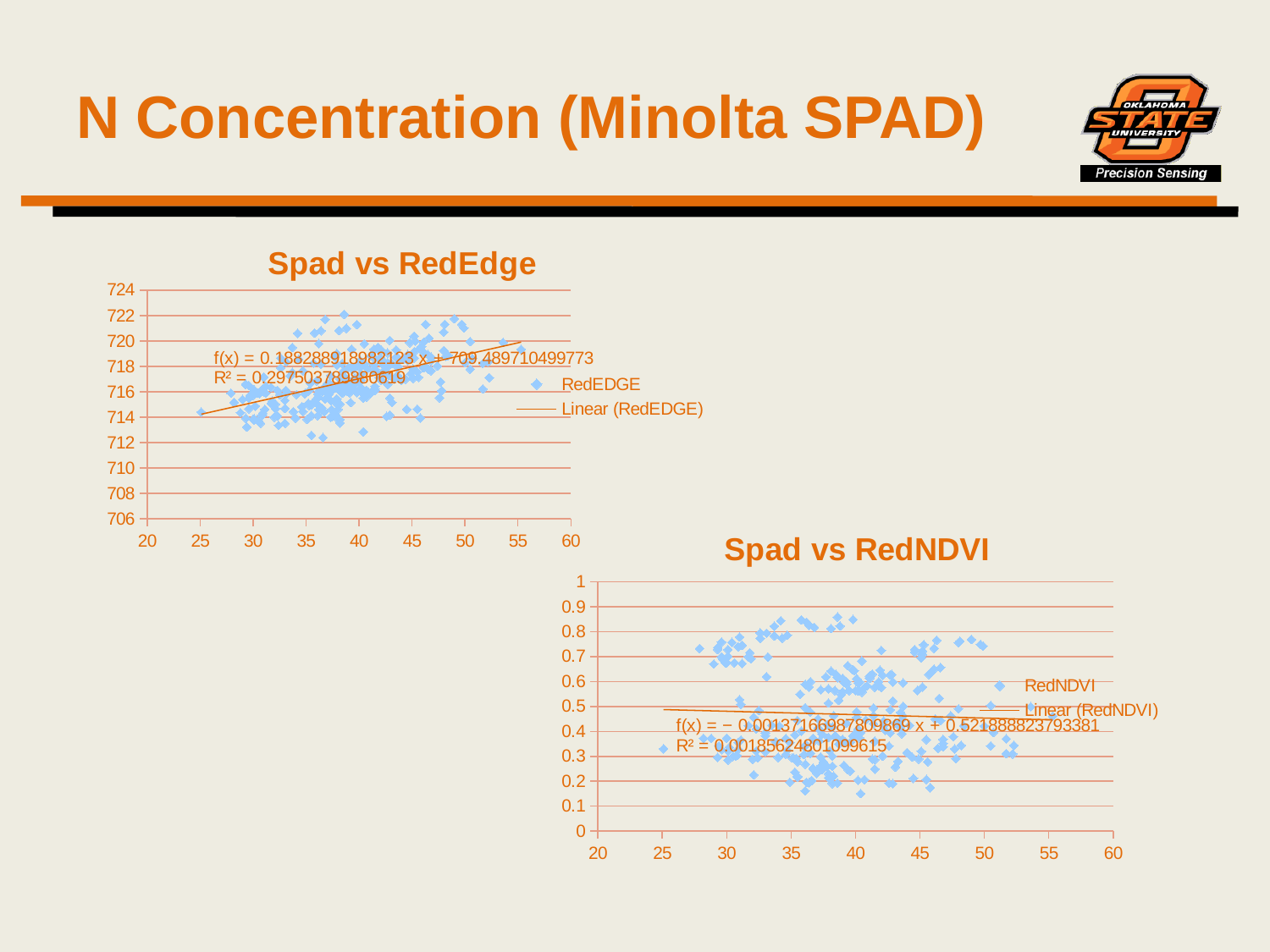
What is the R² value shown on the "Spad vs RedEdge" chart? 0.297503789880619 In the "Spad vs RedEdge" chart, does the fitted linear trendline rise or fall as the x value increases? rise How many entries does the legend of the "Spad vs RedEdge" chart list? 2 What is the slope of the trendline equation shown on the "Spad vs RedEdge" chart? 0.188288918982123 In the "Spad vs RedNDVI" chart, does the fitted linear trendline rise or fall as the x value increases? fall What is the name of the data series in the legend of the "Spad vs RedNDVI" chart (excluding the trendline entry)? RedNDVI What is the R² value shown on the "Spad vs RedNDVI" chart? 0.00185624801099615 Which chart has the larger R² value, "Spad vs RedEdge" or "Spad vs RedNDVI"? Spad vs RedEdge What kind of chart is the "Spad vs RedEdge" chart? scatter chart How many entries does the legend of the "Spad vs RedNDVI" chart list? 2 What kind of chart is the "Spad vs RedNDVI" chart? scatter chart What is the intercept of the trendline equation shown on the "Spad vs RedNDVI" chart? 0.521888823793381